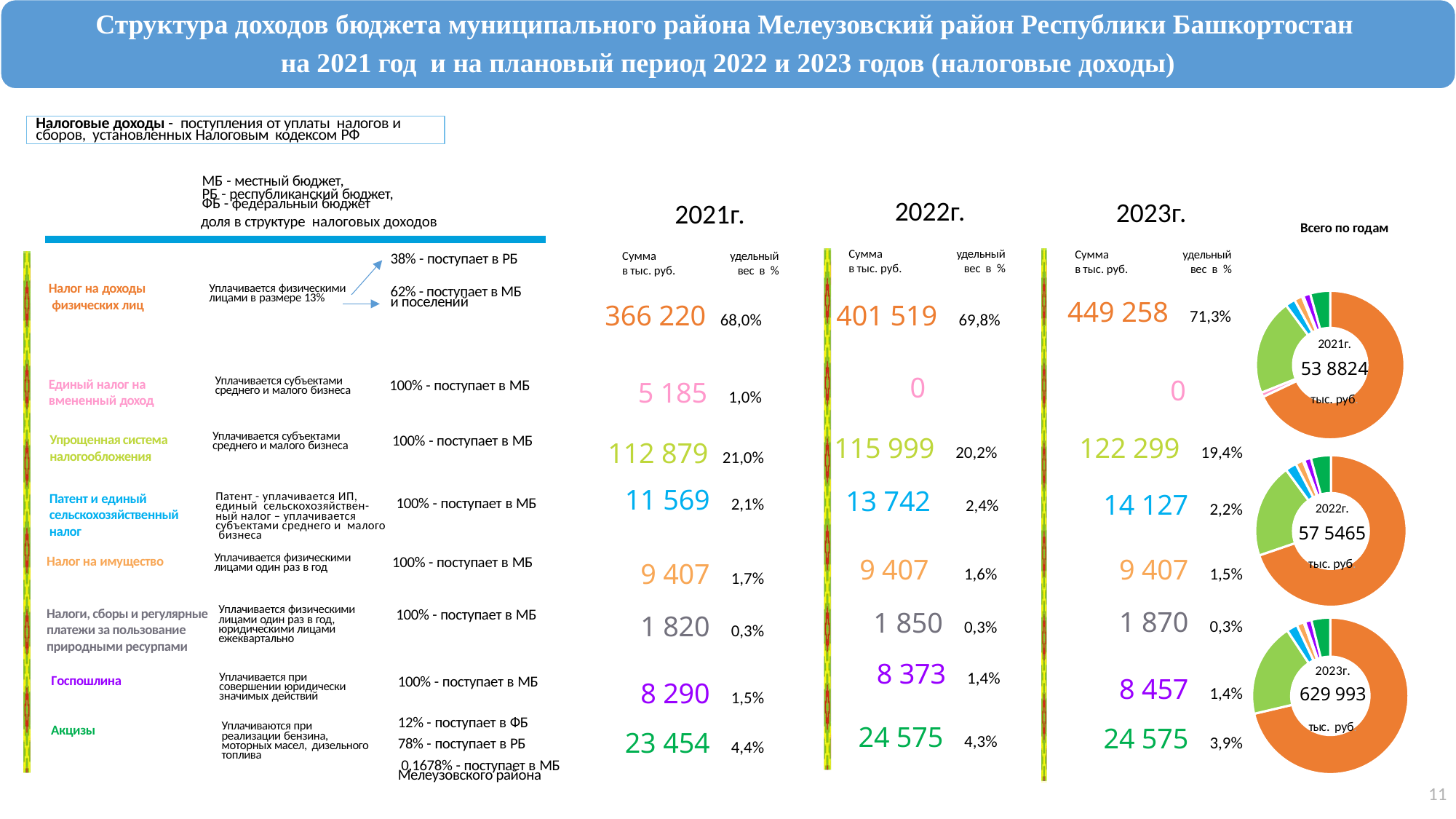
What unit is shown under the centre totals of the donut charts? тыс. руб. How many donut charts are shown under 'Всего по годам'? 3 Do the centre totals of the donut charts rise or fall from 2021 to 2023? rise In the 2022г. donut chart, what total value is printed in the centre? 57 5465 What share of tax revenues does 'Налог на доходы физических лиц' have in 2023? 71,3% In the 2023г. donut chart, what total value is printed in the centre? 629 993 In the 2021г. donut chart, what total value is printed in the centre? 53 8824 What share of tax revenues do 'Акцизы' have in 2023? 3,9% In the 2023г. donut chart, which tax category has the largest slice? Налог на доходы физических лиц What kind of chart is used in the 'Всего по годам' section on the right of the slide? pie (donut) chart What share of tax revenues does 'Упрощенная система налогообложения' have in 2021? 21,0% In the 2022г. donut chart, which slice is larger: 'Налог на доходы физических лиц' or 'Упрощенная система налогообложения'? Налог на доходы физических лиц